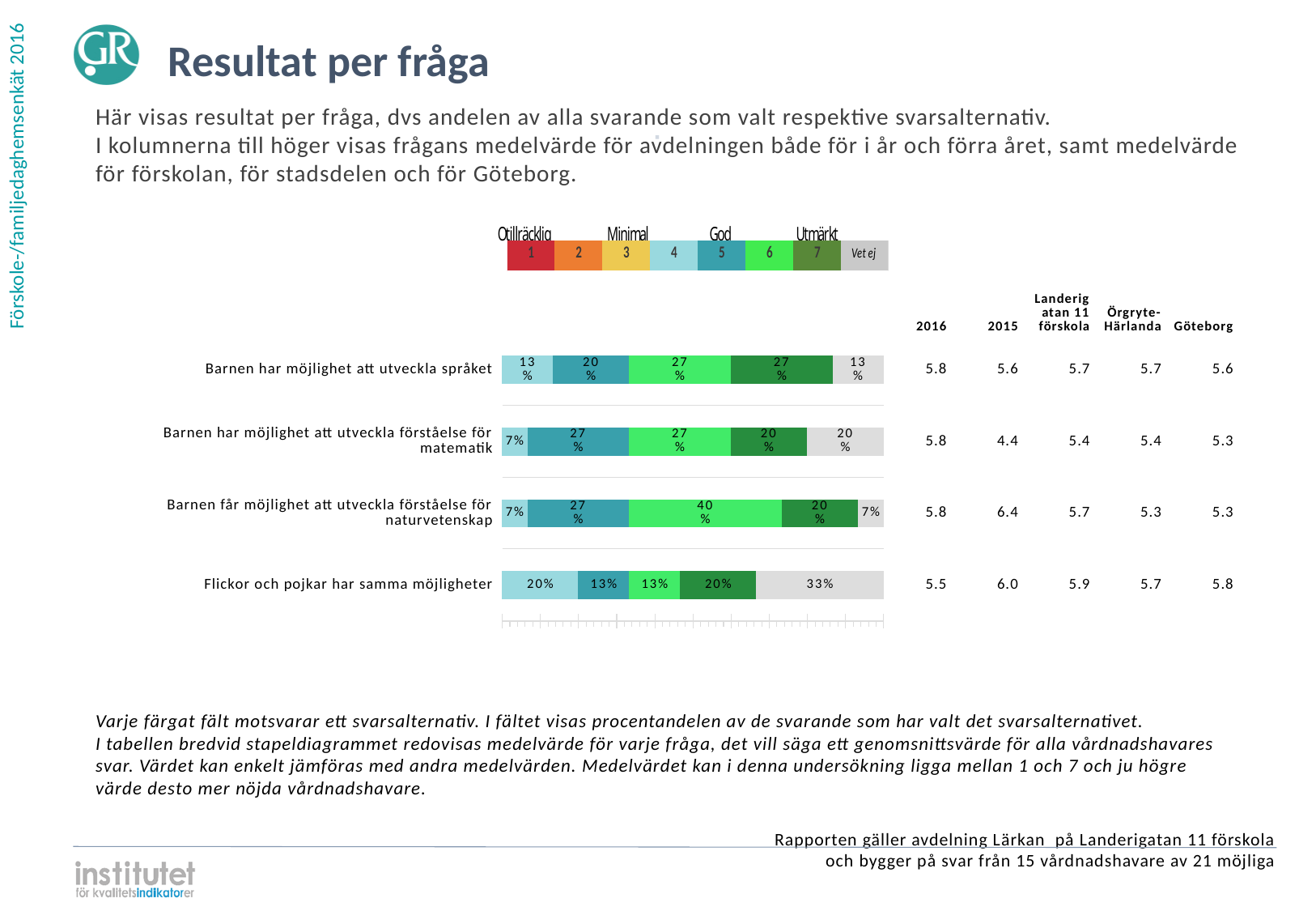
What kind of chart is shown on the slide? Stacked bar chart Which question has the lowest 2016 mean value in the table? Flickor och pojkar har samma möjligheter What is the 2015 mean value for 'Barnen har möjlighet att utveckla förståelse för matematik'? 4.4 Which question has the largest single segment in its bar? Barnen får möjlighet att utveckla förståelse för naturvetenskap What is the 2016 mean value for 'Flickor och pojkar har samma möjligheter'? 5.5 What percentage chose answer 7 for 'Barnen har möjlighet att utveckla språket'? 27% How many questions (categories) are plotted in the bar chart? 4 What percentage chose 'Vet ej' for 'Flickor och pojkar har samma möjligheter'? 33% For 'Flickor och pojkar har samma möjligheter', which is larger: the share for answer 4 or the share for answer 5? Answer 4 What is the difference between the answer 5 share and the answer 4 share for 'Barnen har möjlighet att utveckla förståelse för matematik'? 20% How many answer alternatives does the legend above the chart list? 8 What percentage of respondents chose answer 6 for 'Barnen får möjlighet att utveckla förståelse för naturvetenskap'? 40%